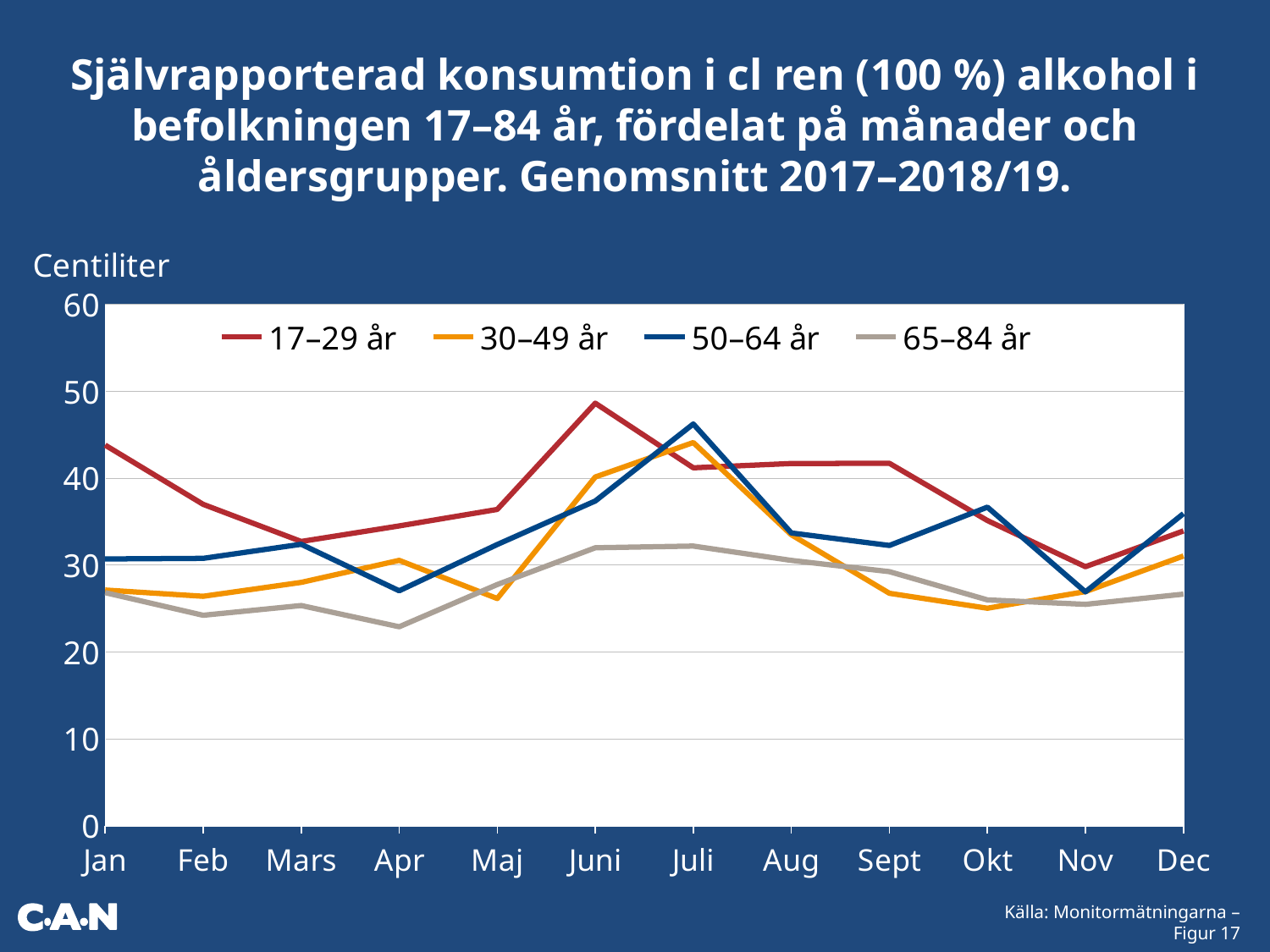
In which month does the 30–49 år series reach its highest value? Juli How many months are plotted along the x axis? 12 Is the value for 65–84 år in Apr greater or less than 30? less How many series does the legend list? 4 What kind of chart is shown on the slide? Line chart Is the value for 17–29 år in Jan greater or less than 40? greater Is the value for 50–64 år in Juli greater or less than 40? greater In which month does the 50–64 år series reach its highest value? Juli Which age group has the highest value in Jan? 17–29 år In Juni, which is larger: the value for 17–29 år or for 30–49 år? 17–29 år What unit is shown as the label of the y axis? Centiliter